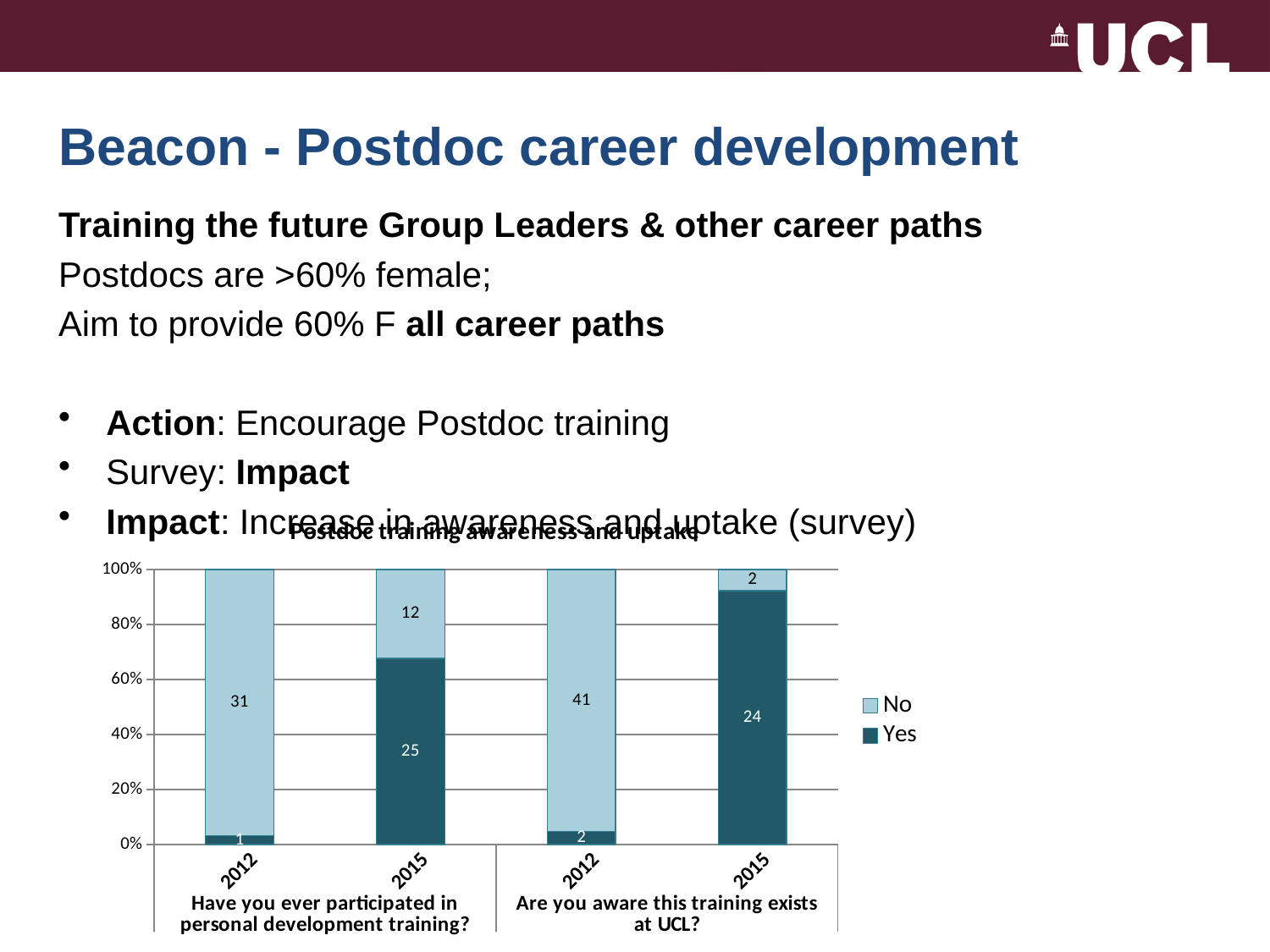
What is the 'Yes' value for 2015 under 'Have you ever participated in personal development training?' 25 What is the 'Yes' value for 2015 under 'Are you aware this training exists at UCL?' 24 What is the 'No' value for 2012 under 'Are you aware this training exists at UCL?' 41 What kind of chart is shown on the slide? Stacked bar chart What is the 'No' value for 2012 under 'Have you ever participated in personal development training?' 31 What is the difference between the 'Yes' values for 2015 and 2012 under 'Have you ever participated in personal development training?' 24 How many series does the chart legend list? 2 Is the 'Yes' share of the 2015 bar under 'Have you ever participated in personal development training?' greater or less than 60%? greater How many bars are plotted in the chart? 4 What is the total of the 2015 bar under 'Are you aware this training exists at UCL?' 26 What are the two series named in the chart legend? No and Yes Under 'Are you aware this training exists at UCL?', which is larger: the 'No' value for 2012 or the 'No' value for 2015? 2012